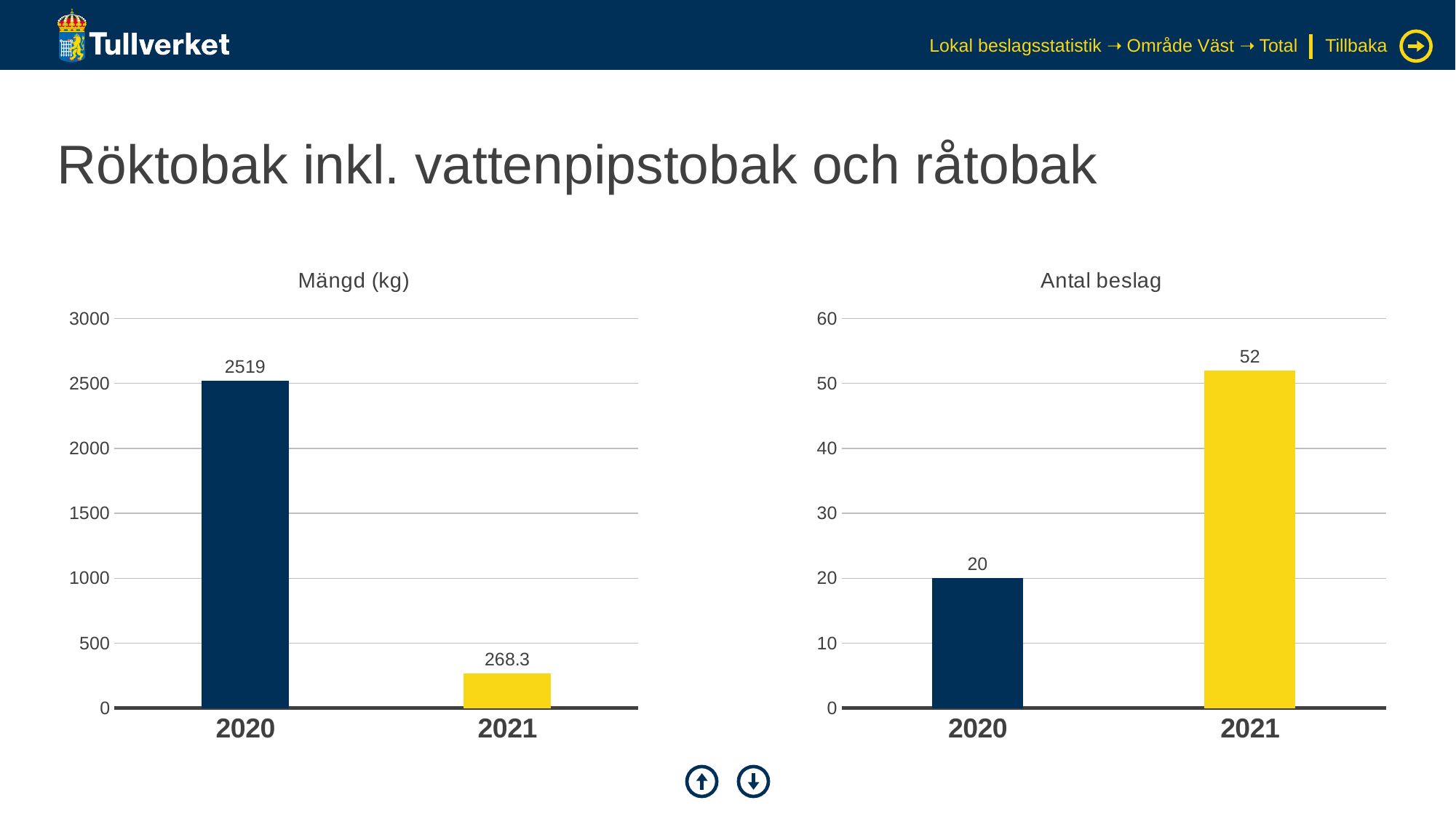
In the 'Mängd (kg)' chart, what is the difference between the values for 2020 and 2021? 2250.7 In the 'Mängd (kg)' chart, do the values rise or fall from 2020 to 2021? fall In the 'Antal beslag' chart, which year has the lowest value? 2020 In the 'Antal beslag' chart, what is the difference between the values for 2021 and 2020? 32 In the 'Mängd (kg)' chart, which year has the highest value? 2020 How many categories does the 'Antal beslag' chart show? 2 What kind of chart is the 'Mängd (kg)' chart? bar chart In the 'Mängd (kg)' chart, what is the value for 2020? 2519 In the 'Mängd (kg)' chart, what is the value for 2021? 268.3 In the 'Antal beslag' chart, what is the value for 2021? 52 In the 'Antal beslag' chart, which is larger, the value for 2020 or 2021? 2021 In the 'Antal beslag' chart, what is the value for 2020? 20